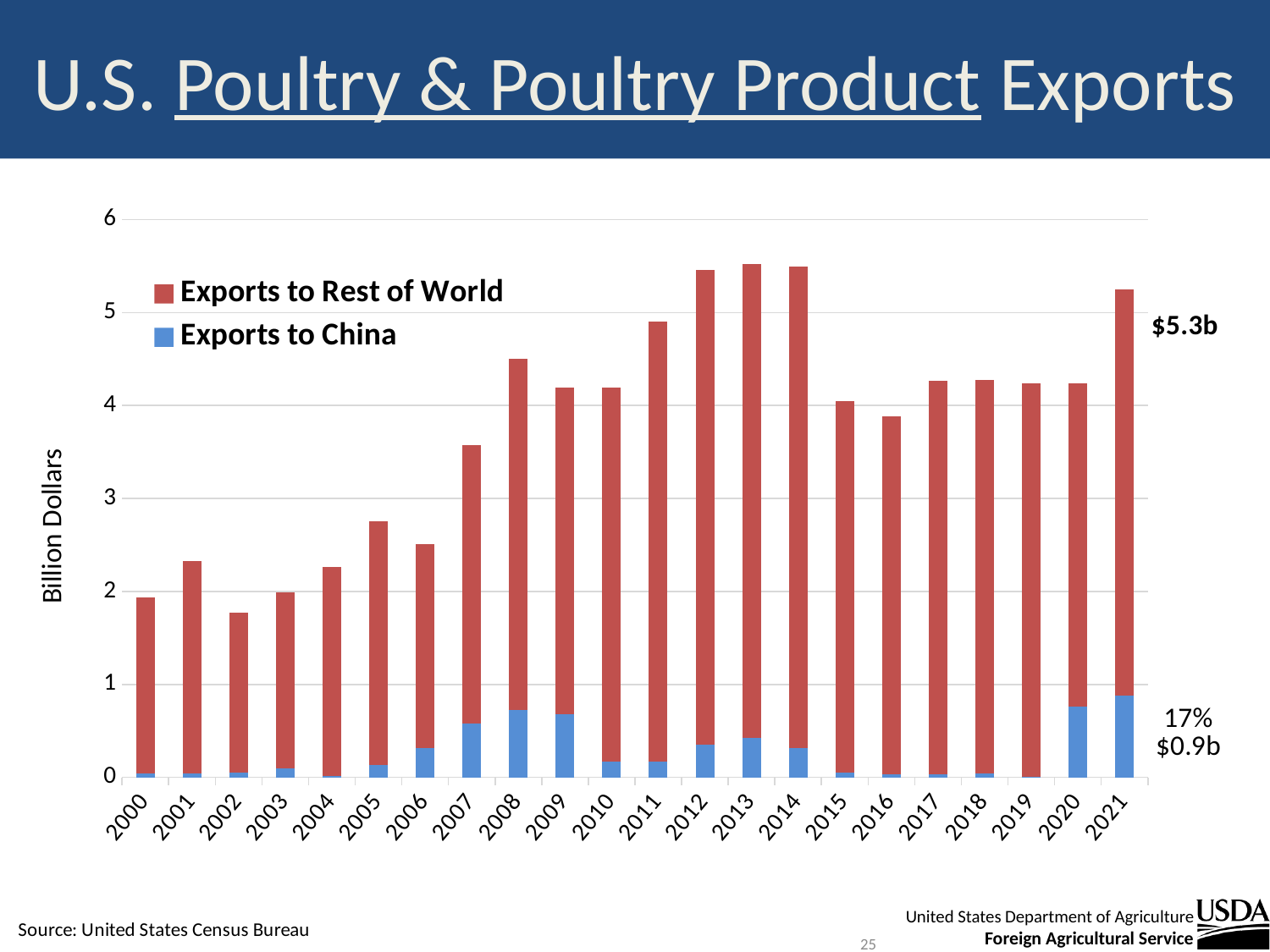
What share of 2021 exports went to China? 17% What kind of chart is shown on the slide? bar chart Is the total export value for 2013 greater or less than 5? greater What is the value of exports to China in 2021? $0.9b How many series does the legend list? 2 How many years are shown on the x axis? 22 What is the total value of U.S. poultry and poultry product exports in 2021? $5.3b Which year has the highest value of exports to China? 2021 Which year has the larger total export value, 2011 or 2015? 2011 What is the label on the y axis? Billion Dollars Is the total export value for 2002 greater or less than 2? less Is the total export value for 2008 greater or less than 4? greater